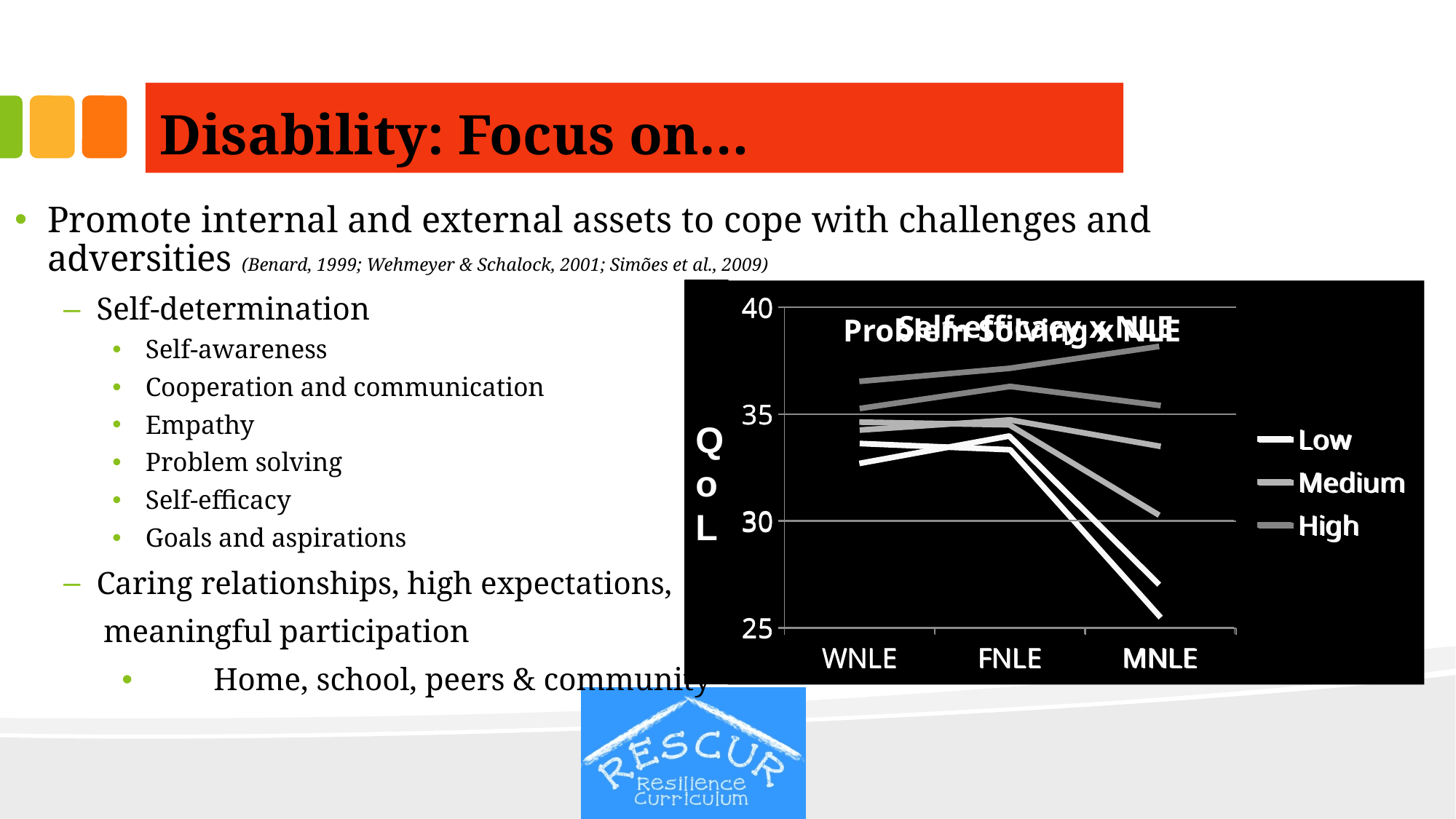
In the chart on the right, is the Low series value at MNLE greater or less than 30? less In the chart on the right, is the Low series value at WNLE greater or less than 30? greater How many series does the legend of the chart on the right list? 3 In the chart on the right, is the Low series value at MNLE greater or less than the Low series value at FNLE? less What label is shown on the y axis of the chart on the right? QoL How many categories are shown on the x axis of the chart on the right? 3 In the chart on the right, at which x-axis category is the Low series lowest? MNLE What kind of chart is shown on the right side of the slide? line chart In the chart on the right, do the Low series values rise or fall from FNLE to MNLE? fall What are the three series named in the legend of the chart on the right? Low, Medium, High